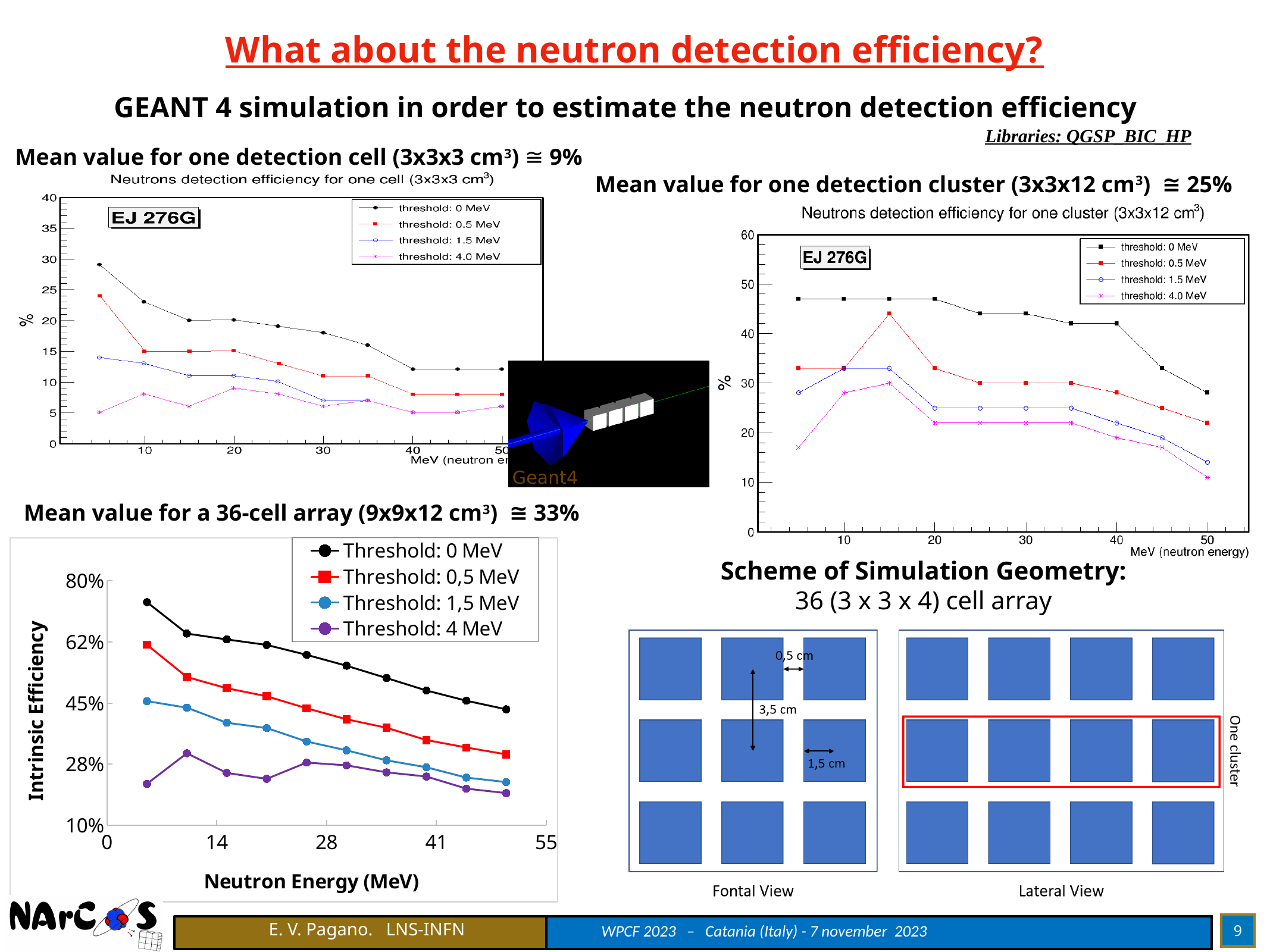
In the bottom-left chart (36-cell array), which series has the lowest values across all neutron energies? Threshold: 4 MeV In the 'Neutrons detection efficiency for one cluster (3x3x12 cm³)' chart, is the value for threshold: 4.0 MeV at 50 MeV greater or less than 20? less How many series does the legend of the 'Neutrons detection efficiency for one cluster (3x3x12 cm³)' chart list? 4 In the bottom-left chart (36-cell array), what is the label of the x axis? Neutron Energy (MeV) What kind of chart is the 'Neutrons detection efficiency for one cell (3x3x3 cm³)' chart? line chart In the bottom-left chart (36-cell array), how many series does the legend list? 4 In the 'Neutrons detection efficiency for one cell (3x3x3 cm³)' chart, which is larger at 10 MeV: threshold: 0.5 MeV or threshold: 1.5 MeV? threshold: 0.5 MeV In the 'Neutrons detection efficiency for one cluster (3x3x12 cm³)' chart, is the value for threshold: 0 MeV at 10 MeV greater or less than 40? greater In the bottom-left chart (36-cell array), what is the label of the y axis? Intrinsic Efficiency In the 'Neutrons detection efficiency for one cell (3x3x3 cm³)' chart, is the value for threshold: 0 MeV at 5 MeV greater or less than 25? greater In the bottom-left chart (36-cell array), does the Threshold: 0 MeV series rise or fall as neutron energy increases? fall In the bottom-left chart (36-cell array), which series has the highest values across all neutron energies? Threshold: 0 MeV